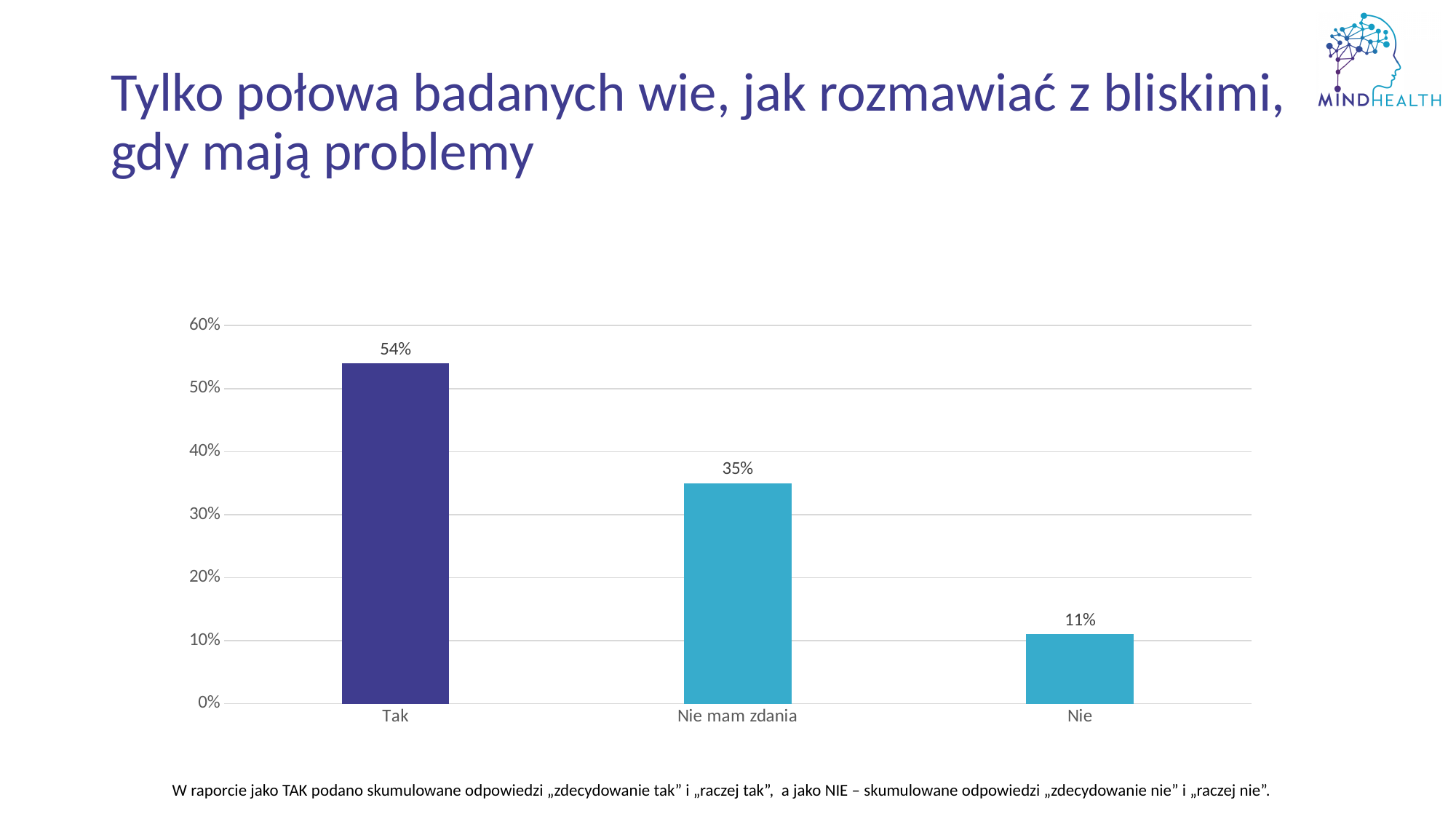
Which is larger, the value for "Nie mam zdania" or the value for "Nie"? Nie mam zdania How many categories are shown on the chart? 3 What kind of chart is shown on the slide? bar chart Do the values rise or fall from left to right along the x axis? fall What is the difference between the values for "Tak" and "Nie"? 43% What is the value for "Tak"? 54% What is the value for "Nie mam zdania"? 35% What is the value for "Nie"? 11% Is the value for "Tak" greater or less than 50%? greater Which category has the lowest value? Nie What is the difference between the values for "Tak" and "Nie mam zdania"? 19% Which category has the highest value? Tak